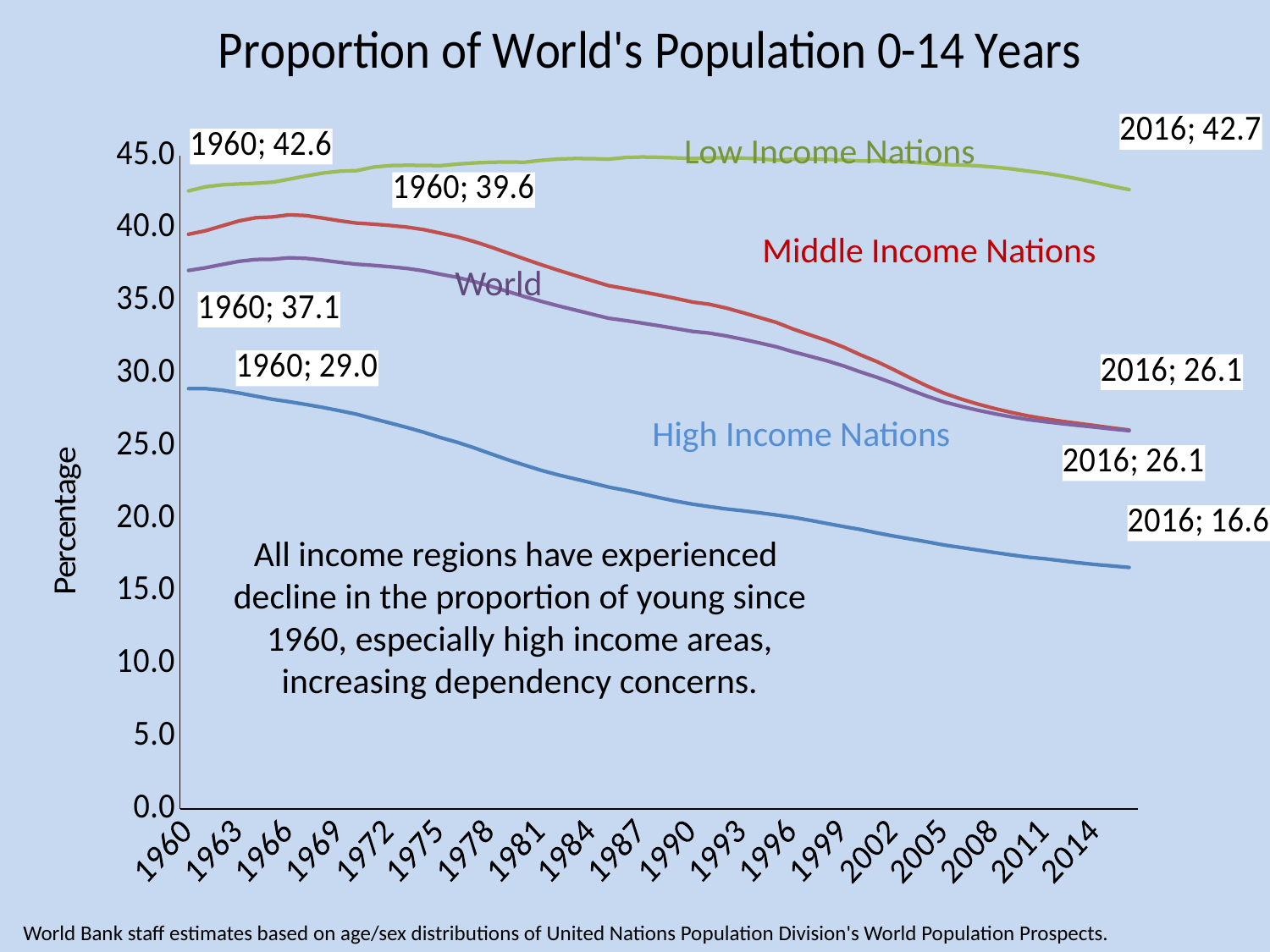
What is the title of the chart? Proportion of World's Population 0-14 Years What is the value for Low Income Nations in 2016? 42.7 What is the value for High Income Nations in 2016? 16.6 Which series has the lowest value in 1960? High Income Nations What is the value for Low Income Nations in 1960? 42.6 What is the value for World in 1960? 37.1 Is the value for High Income Nations in 1990 greater or less than 25.0? less What type of chart is shown on the slide? line chart Which series has the highest value in 2016? Low Income Nations What is the value for Middle Income Nations in 1960? 39.6 Does the High Income Nations line rise or fall from 1960 to 2016? fall